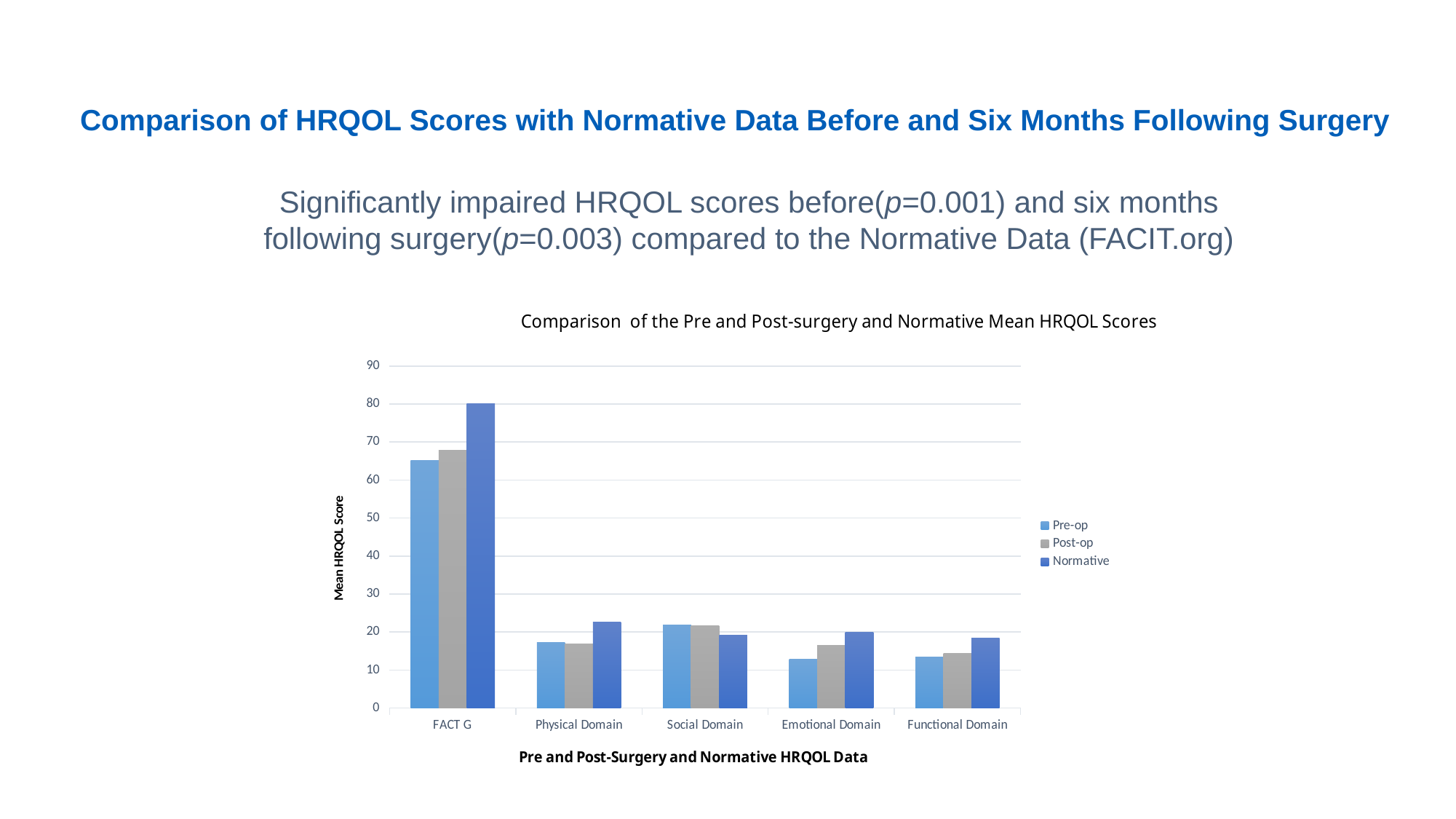
For Emotional Domain, which is larger: the Pre-op value or the Post-op value? Post-op Is the Pre-op value for FACT G greater or less than 60? greater What is the title of the y axis of the chart? Mean HRQOL Score Is the Pre-op value for Emotional Domain greater or less than 20? less Which category has the highest Normative value? FACT G How many series does the chart's legend list? 3 Is the Normative value for FACT G greater or less than 70? greater What kind of chart is shown on the slide? Bar chart How many categories are shown on the x axis of the chart? 5 For FACT G, which is larger: the Pre-op value or the Normative value? Normative For Social Domain, which is larger: the Pre-op value or the Normative value? Pre-op What is the title of the chart? Comparison of the Pre and Post-surgery and Normative Mean HRQOL Scores